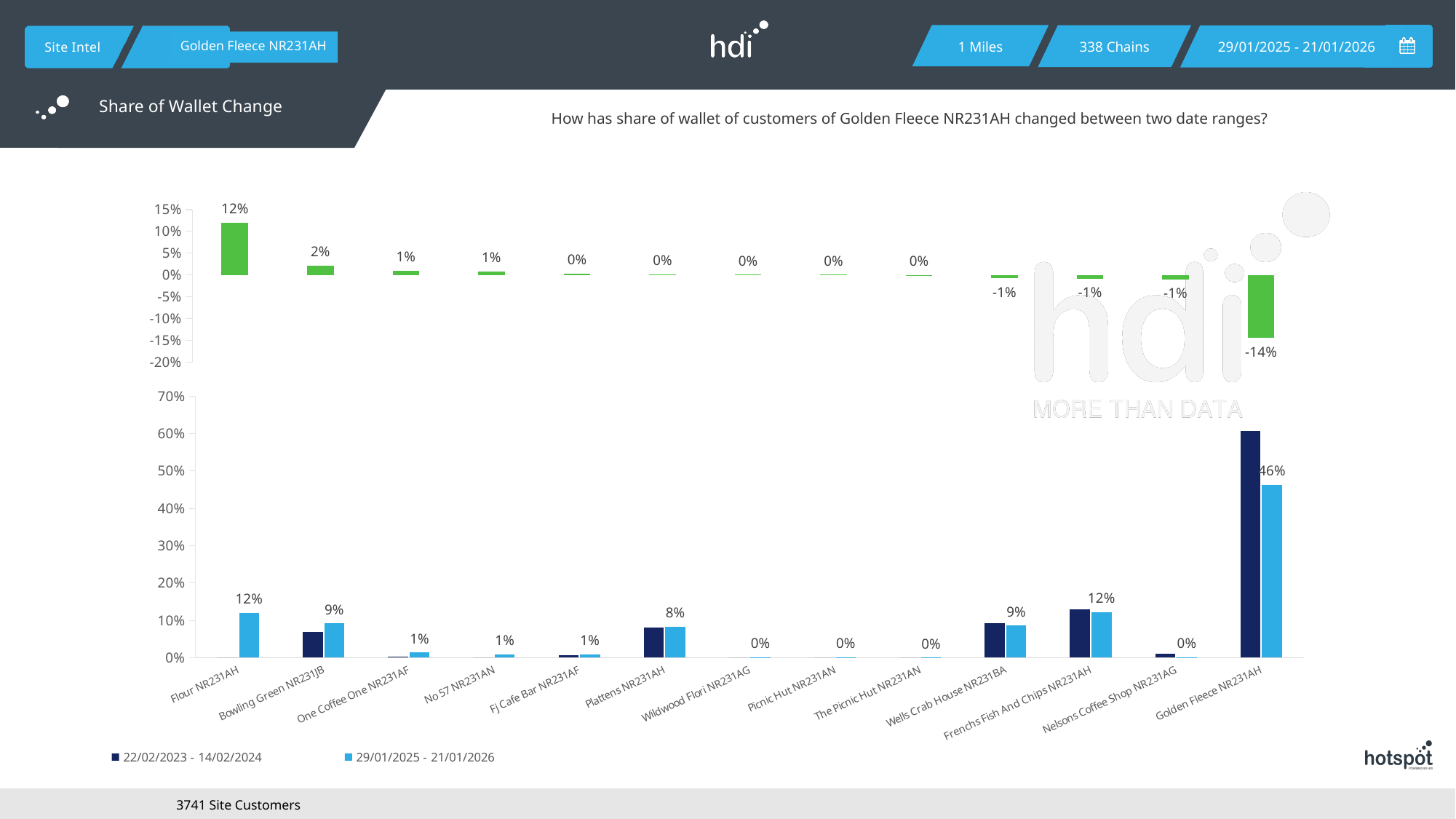
In the top chart (share of wallet change), what is the value for Flour NR231AH? 12% In the top chart (share of wallet change), what is the value for Wells Crab House NR231BA? -1% In the bottom chart, what is the value for Plattens NR231AH in the 29/01/2025 - 21/01/2026 series? 8% In the top chart (share of wallet change), which category has the lowest value? Golden Fleece NR231AH In the top chart (share of wallet change), which category has the highest value? Flour NR231AH How many series does the legend of the bottom chart list? 2 In the bottom chart, is the value for Golden Fleece NR231AH in the 22/02/2023 - 14/02/2024 series greater or less than 50%? greater In the top chart (share of wallet change), what is the difference between the values for Flour NR231AH and Bowling Green NR231JB? 10% How many categories are shown on the x axis of the bottom chart? 13 In the bottom chart, which is larger for Golden Fleece NR231AH: the 22/02/2023 - 14/02/2024 value or the 29/01/2025 - 21/01/2026 value? 22/02/2023 - 14/02/2024 In the top chart (share of wallet change), what is the value for Golden Fleece NR231AH? -14% In the bottom chart, what is the value for Golden Fleece NR231AH in the 29/01/2025 - 21/01/2026 series? 46%